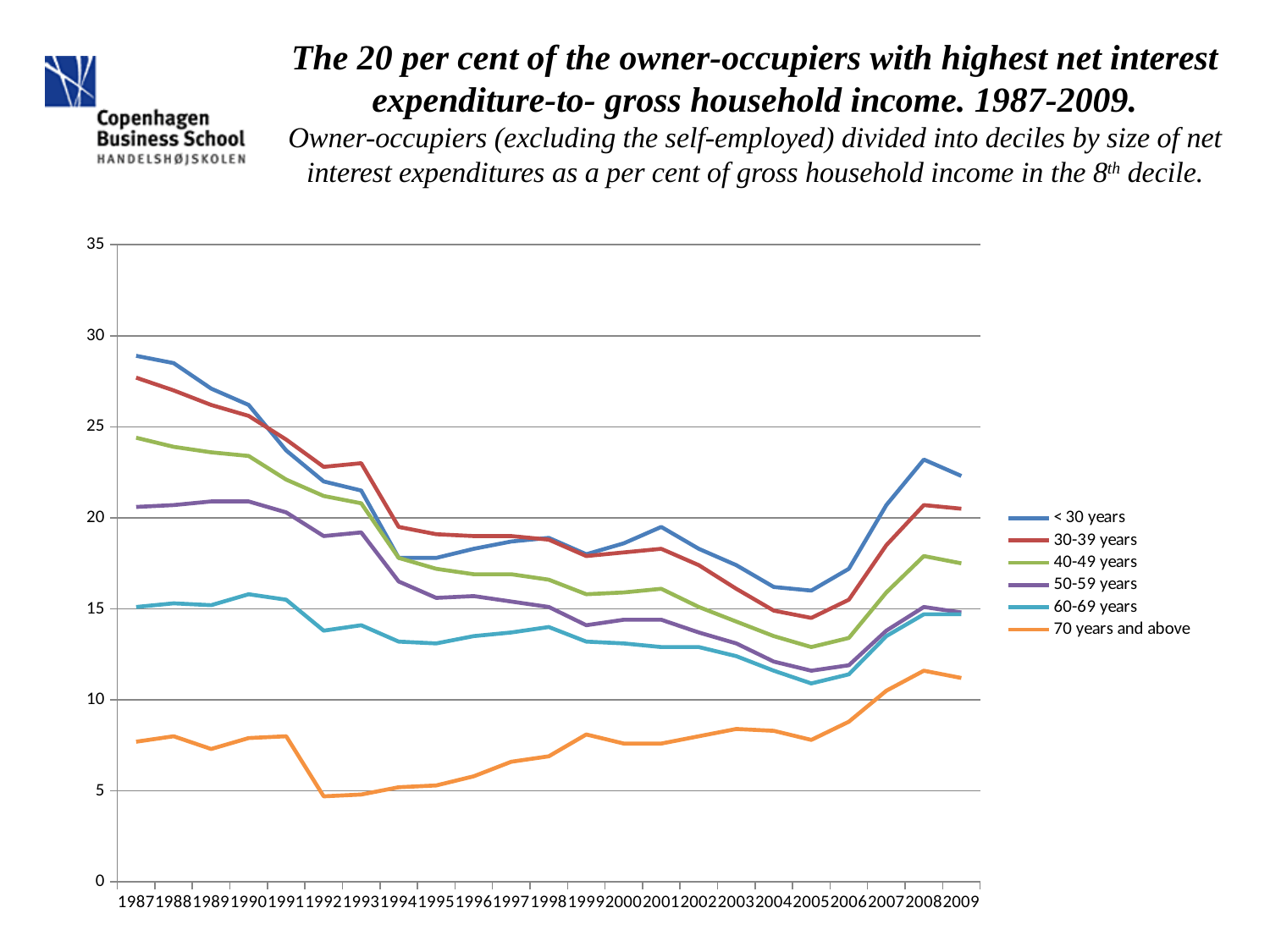
Is the value for 70 years and above in 1992 greater or less than 10? less In 2009, which is larger: the value for 30-39 years or the value for 50-59 years? 30-39 years Is the value for 60-69 years in 2005 greater or less than 15? less Is the value for < 30 years in 1987 greater or less than 25? greater Which age group has the highest value in 2009? < 30 years How many years are plotted along the x axis? 23 Which series is drawn with the orange line? 70 years and above Does the value for < 30 years rise or fall between 1987 and 1994? fall Which age group has the highest value in 1987? < 30 years How many series does the legend list? 6 What kind of chart is shown on the slide? line chart Which age group has the lowest value in 1987? 70 years and above